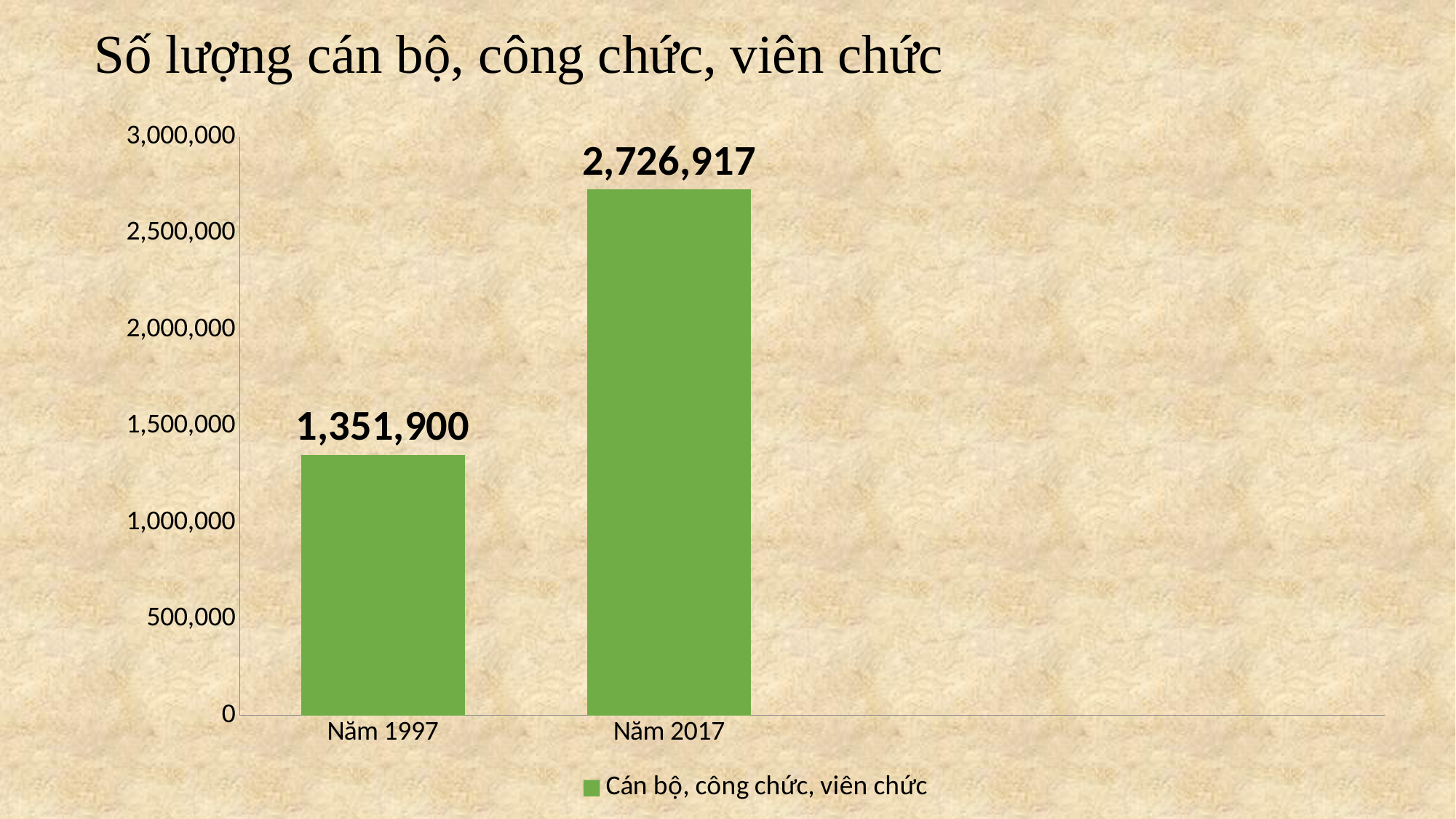
What kind of chart is shown on the slide? bar chart Is the value for Năm 2017 greater or less than 2,500,000? greater How many categories are shown on the x axis? 2 Which category has the lowest value? Năm 1997 Which category has the highest value? Năm 2017 Which is larger, the value for Năm 1997 or the value for Năm 2017? Năm 2017 What is the difference between the values for Năm 2017 and Năm 1997? 1,375,017 How many series does the legend list? 1 What is the value for Năm 2017? 2,726,917 What is the legend entry for the series shown? Cán bộ, công chức, viên chức Is the value for Năm 1997 greater or less than 1,500,000? less What is the value for Năm 1997? 1,351,900